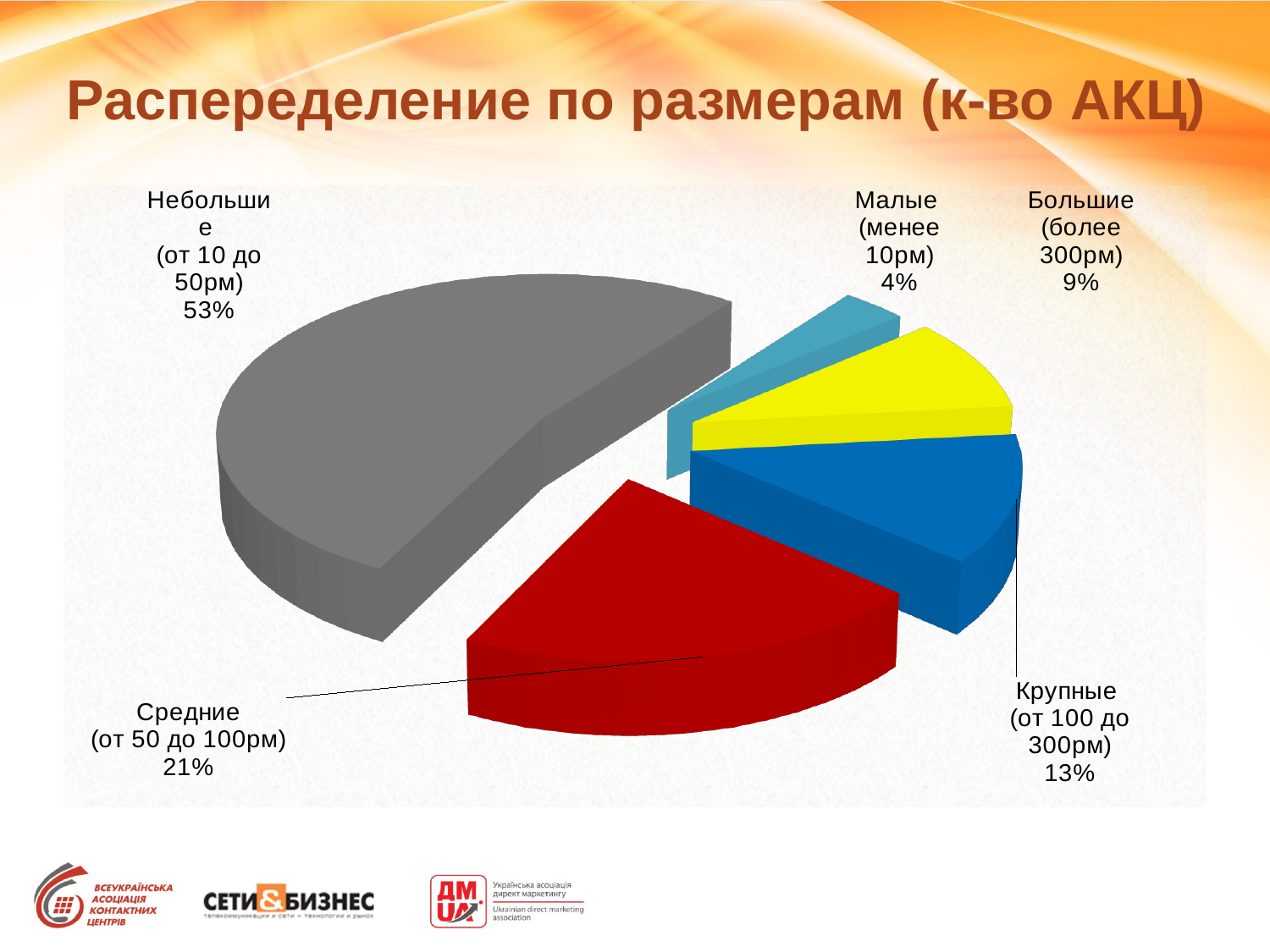
What percentage is shown for the Малые (менее 10рм) category? 4% What type of chart is shown on the slide? Pie chart Which category has the largest share of the pie? Небольшие (от 10 до 50рм) How many categories are shown in the pie chart? 5 What share of the pie does the Небольшие (от 10 до 50рм) slice represent? 53% What percentage is shown for the Большие (более 300рм) category? 9% What percentage is shown for the Средние (от 50 до 100рм) category? 21% What percentage is shown for the Крупные (от 100 до 300рм) category? 13% What is the difference in percentage points between the Средние (от 50 до 100рм) and Крупные (от 100 до 300рм) slices? 8 Which category has the smallest share of the pie? Малые (менее 10рм) Which is larger: the share for Большие (более 300рм) or the share for Крупные (от 100 до 300рм)? Крупные (от 100 до 300рм) What is the title of the slide? Распеределение по размерам (к-во АКЦ)